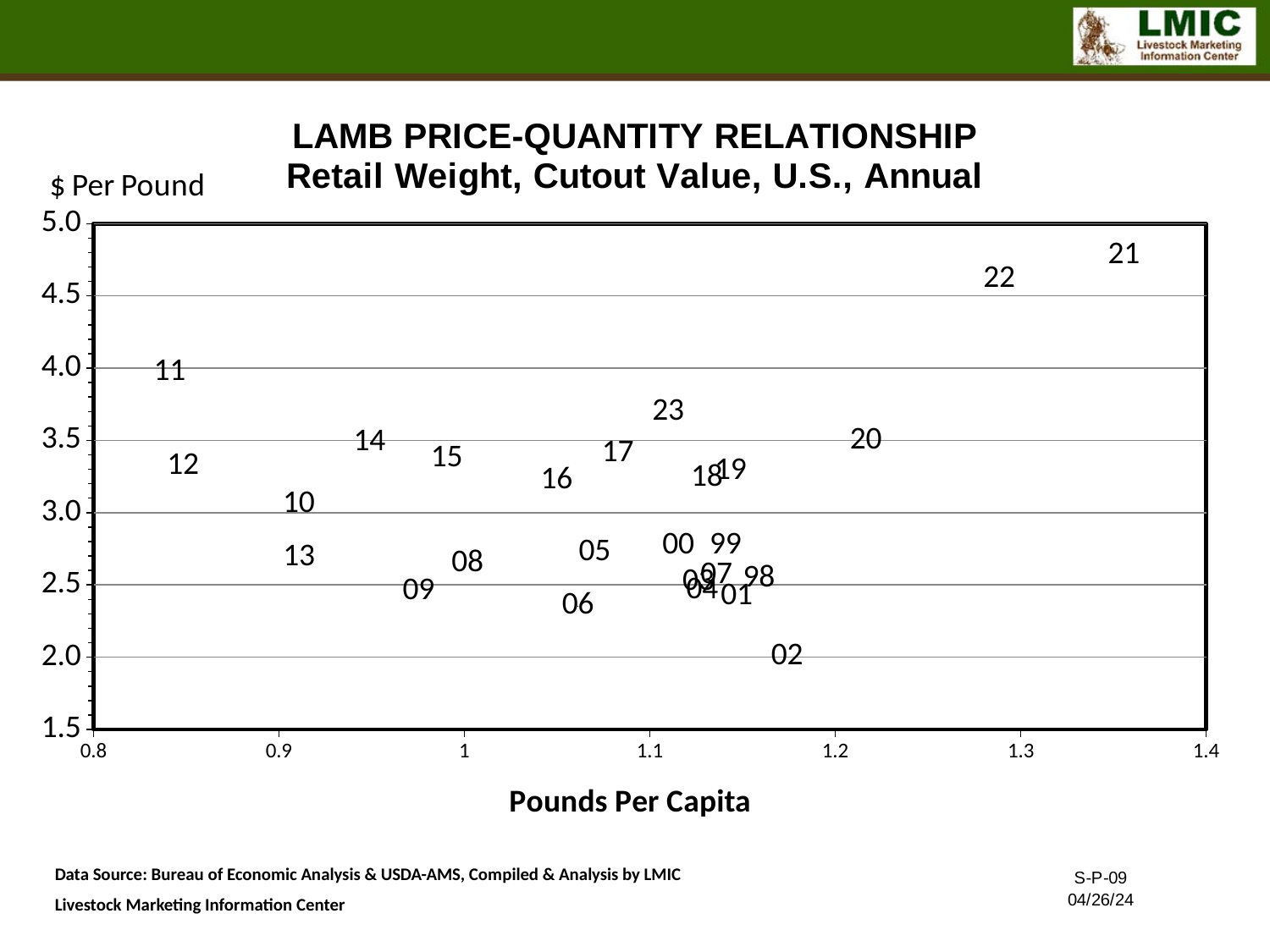
Is the $ per pound value for year 21 greater or less than 4.5? greater Which year has the lowest $ per pound value? 02 Which year has a higher $ per pound value, 06 or 02? 06 What is the label of the x axis? Pounds Per Capita Which year has the highest pounds per capita value? 21 Is the pounds per capita value for year 14 greater or less than 1? less What kind of chart is shown on the slide? Scatter chart Is the $ per pound value for year 02 greater or less than 2.5? less Which year has the highest $ per pound value? 21 Which year has a higher $ per pound value, 22 or 11? 22